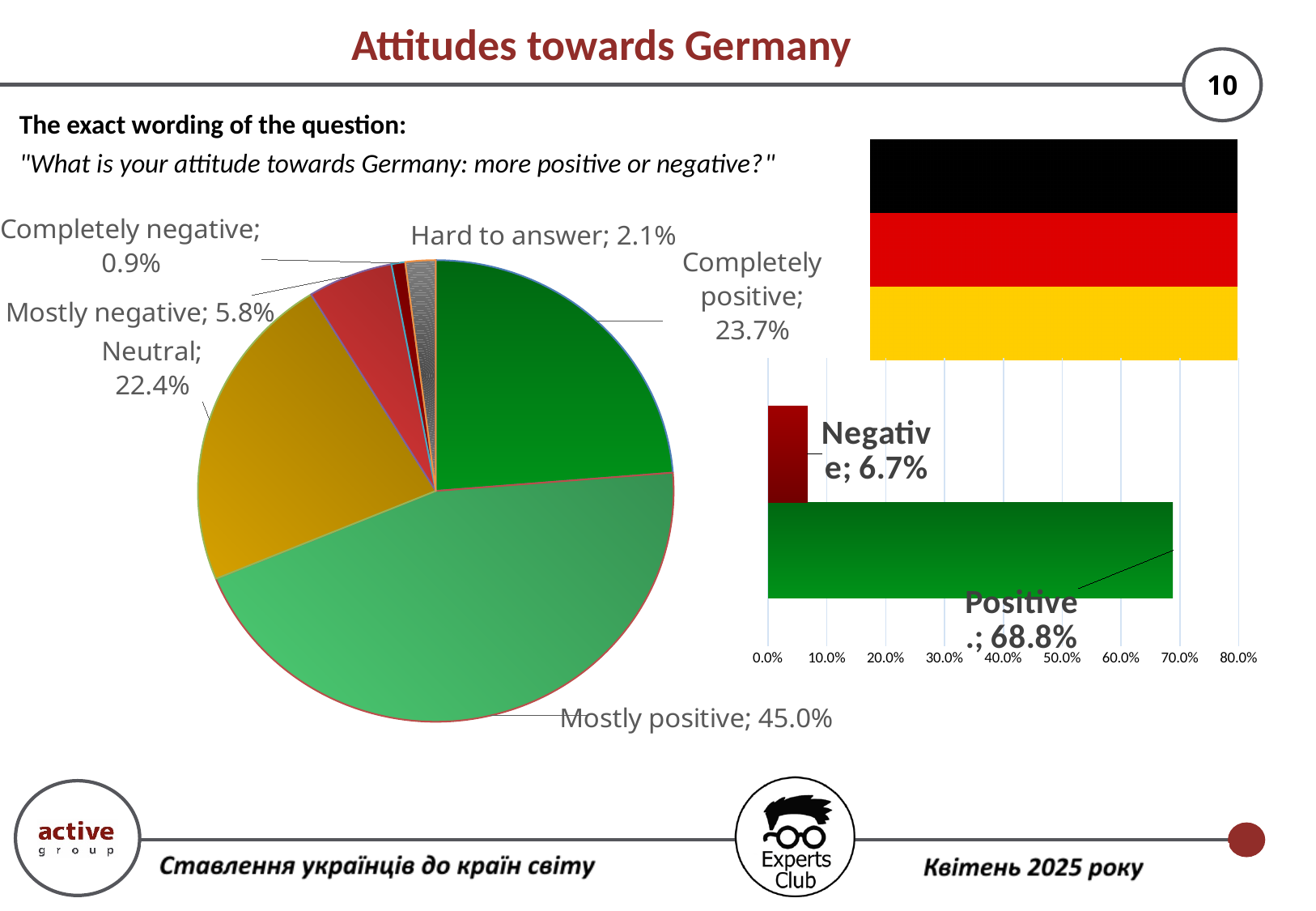
In the bar chart on the right, what is the value for Positive? 68.8% In the pie chart on the left, which category has the smallest share? Completely negative In the pie chart on the left, which is larger: Mostly negative or Hard to answer? Mostly negative In the bar chart on the right, what is the difference between Positive and Negative? 62.1% In the pie chart on the left, what is the value for Mostly positive? 45.0% How many categories does the pie chart on the left show? 6 In the pie chart on the left, what is the difference between Completely positive and Neutral? 1.3% In the pie chart on the left, what is the value for Completely negative? 0.9% In the pie chart on the left, what is the value for Neutral? 22.4% In the pie chart on the left, which category has the largest share? Mostly positive In the bar chart on the right, is the value for Positive greater or less than 60.0%? greater What kind of chart is the chart on the right side of the slide? Bar chart